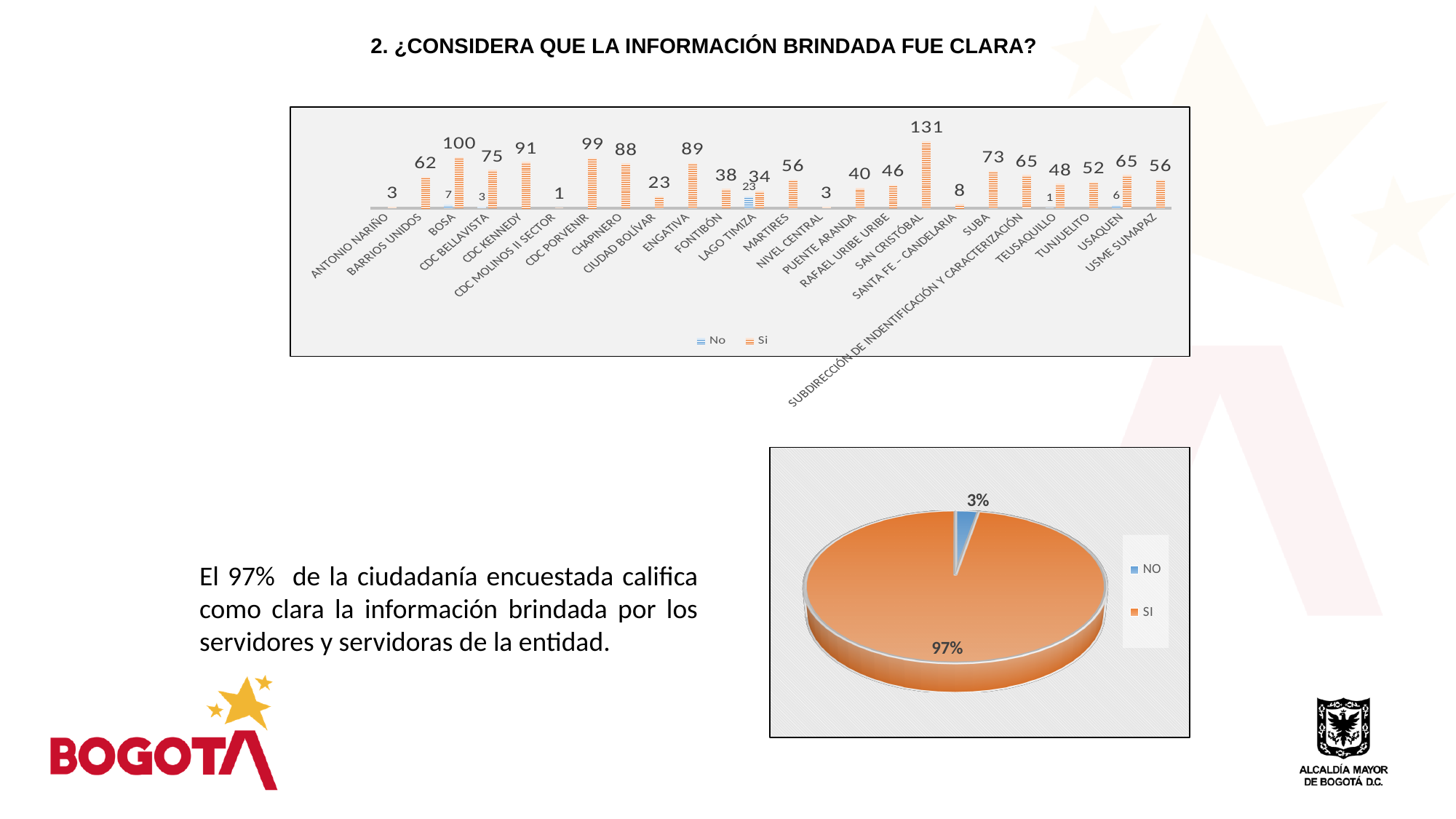
In the top bar chart, what is the Si value for SAN CRISTÓBAL? 131 In the top bar chart, which has a larger Si value, CDC PORVENIR or CHAPINERO? CDC PORVENIR In the top bar chart, what is the difference between the Si values for BOSA and CDC BELLAVISTA? 25 How many categories are shown on the x axis of the top bar chart? 24 What kind of chart is the bottom chart on the slide? pie chart In the bottom pie chart, what share does NO have? 3% In the bottom pie chart, what share does SI have? 97% What kind of chart is the top chart on the slide? bar chart How many series does the legend of the top bar chart list? 2 In the top bar chart, which category has the highest Si value? SAN CRISTÓBAL In the top bar chart, what is the No value for LAGO TIMIZA? 23 In the top bar chart, what is the Si value for BOSA? 100